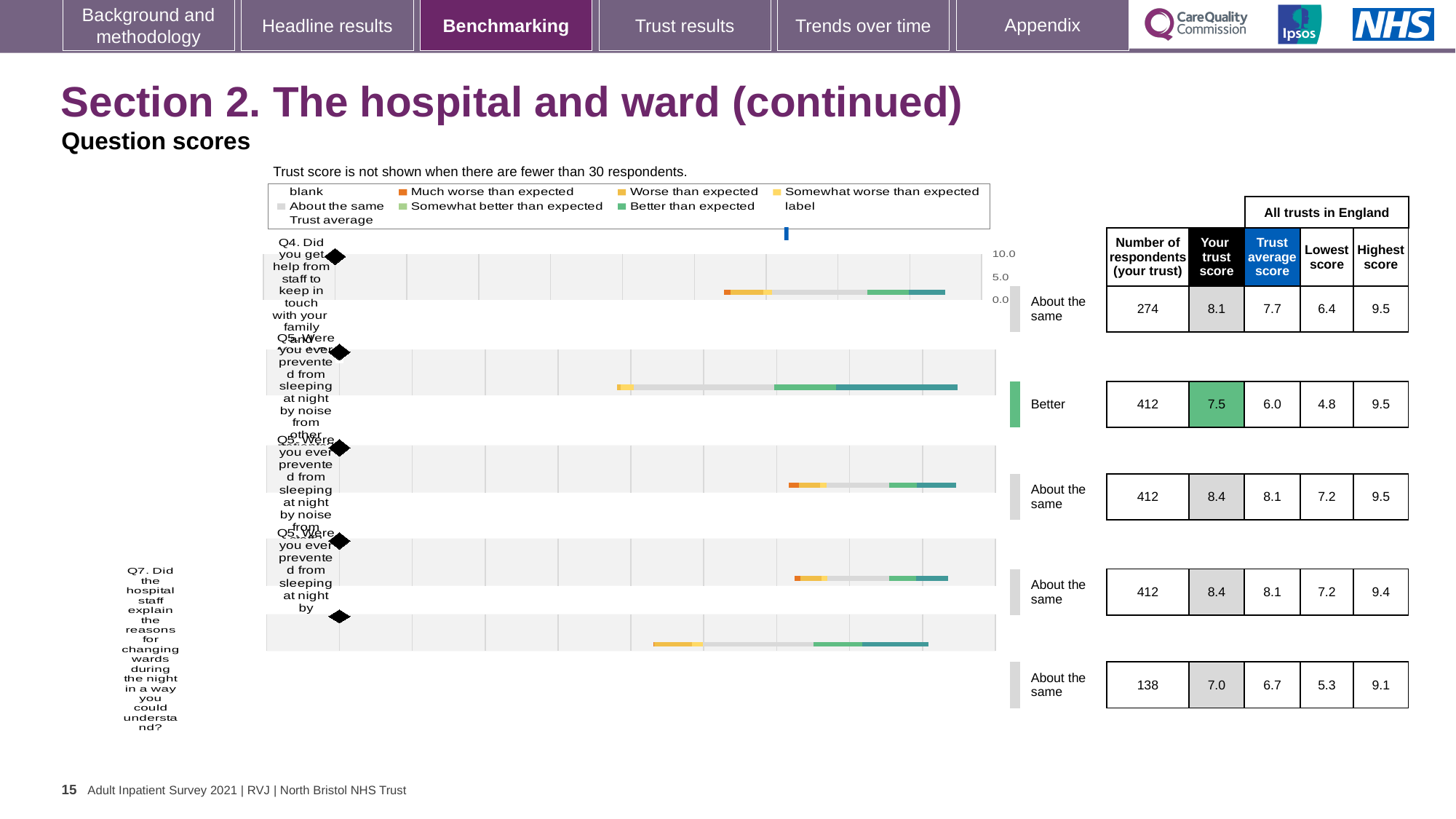
How many respondents are listed for Q4 (the first row)? 274 By how much does the 'Your trust score' for Q4 exceed the trust average score for Q4? 0.4 What is the 'Your trust score' for Q7 (the last row of the chart)? 7.0 What is the 'Your trust score' for Q4 (the first row of the chart)? 8.1 What is the trust average score for the second row of the chart? 6.0 What kind of chart is used to show the question scores on this slide? Bar chart Which row is rated 'Better' rather than 'About the same'? The second row Which row has the lowest number of respondents? Q7 (the last row), 138 What is the difference between the highest score and the lowest score for Q7 (the last row)? 3.8 Which row has the lowest 'Your trust score'? Q7 (the last row), 7.0 For Q4, which is larger: the 'Your trust score' or the trust average score? Your trust score How many question rows (bars) are plotted in the benchmarking chart? 5